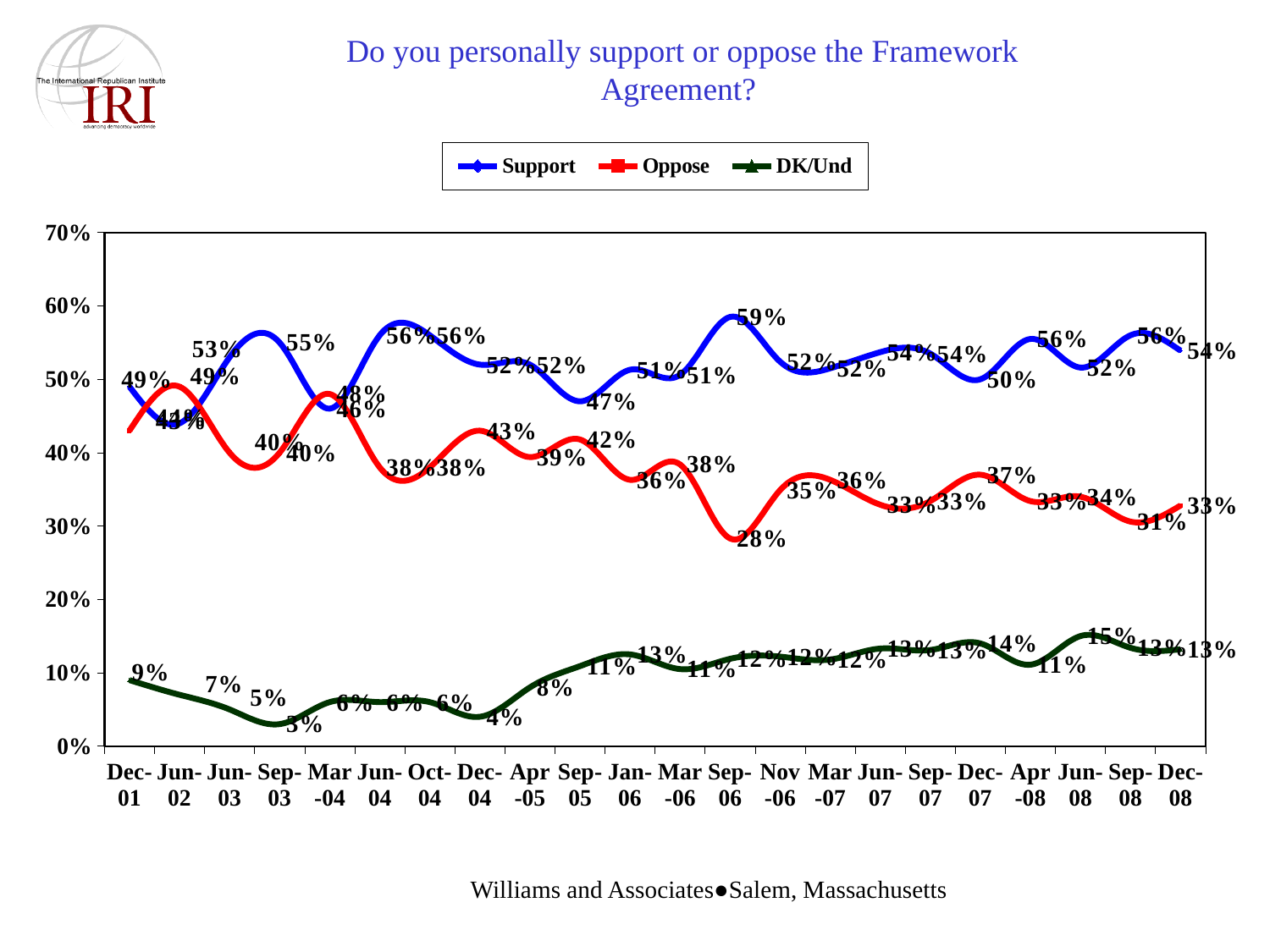
How many series does the legend list? 3 What is the difference between the Support and Oppose values at Sep-06? 31% At which date does the Oppose series reach its lowest value? Sep-06 What is the difference between the Support value at Dec-08 and the Support value at Dec-01? 5% What is the Oppose value for Dec-08? 33% What is the title of the chart? Do you personally support or oppose the Framework Agreement? What type of chart is shown on the slide? line chart What is the Support value for Sep-06? 59% Which is larger at Dec-01, Support or Oppose? Support At which date does the Support series reach its highest value? Sep-06 At which date does the DK/Und series reach its highest value? Jun-08 What is the DK/Und value for Sep-03? 3%